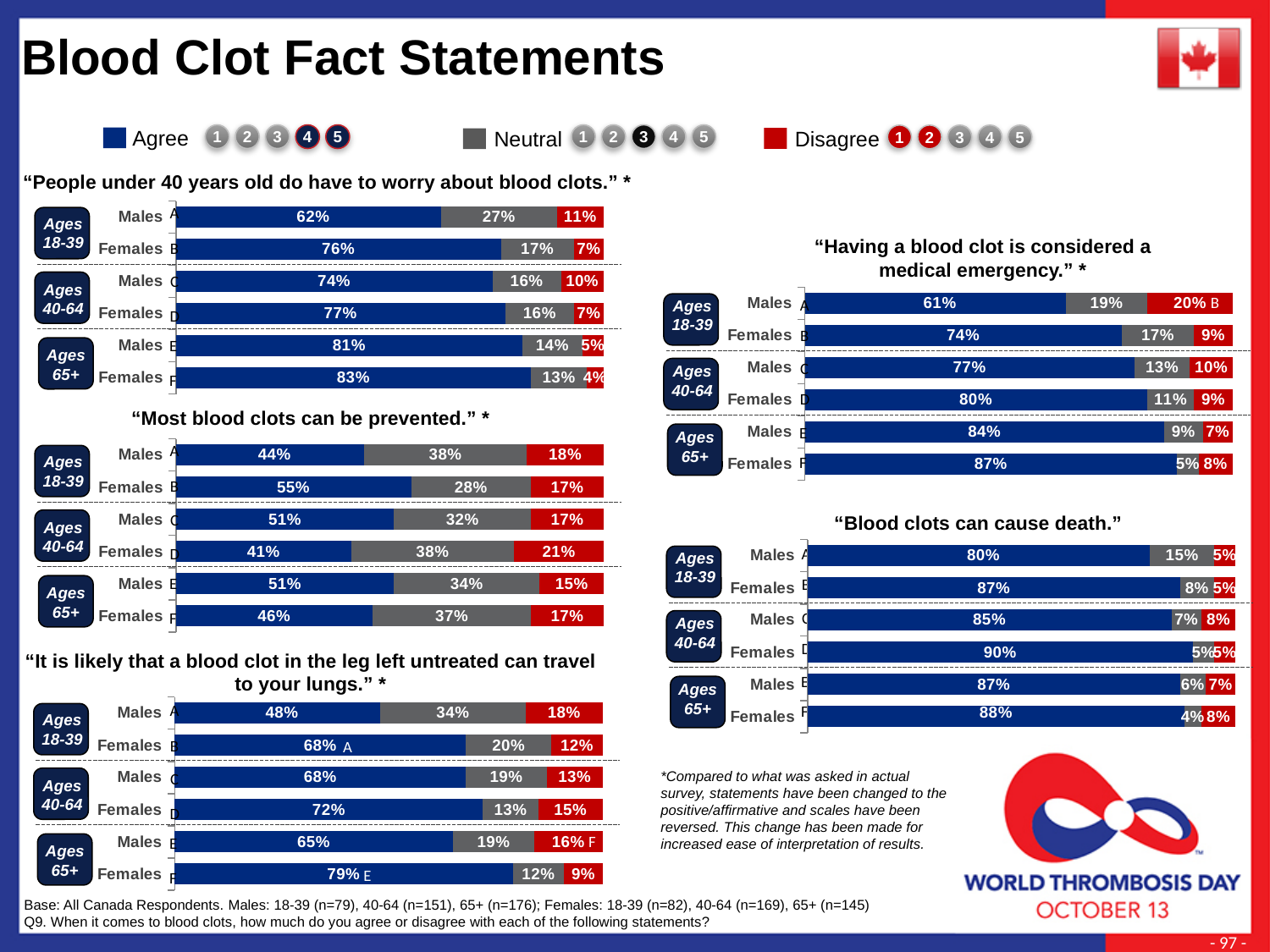
In the chart "Most blood clots can be prevented.", what is the Disagree percentage for Females aged 40-64? 21% In the chart "It is likely that a blood clot in the leg left untreated can travel to your lungs.", what is the Neutral percentage for Males aged 18-39? 34% In the chart "People under 40 years old do have to worry about blood clots.", which group has the highest Agree percentage? Females 65+ In the chart "It is likely that a blood clot in the leg left untreated can travel to your lungs.", what is the difference between the Agree percentages of Females 65+ and Males 65+? 14% In the chart "Blood clots can cause death.", what percentage of Females aged 40-64 agree? 90% In the chart "Most blood clots can be prevented.", which group has the lowest Agree percentage? Females 40-64 How many response categories does the legend at the top of the slide list? 3 What type of chart is used for "Most blood clots can be prevented."? Stacked bar chart In the chart "People under 40 years old do have to worry about blood clots.", what percentage of Males aged 18-39 agree? 62% In the chart "Having a blood clot is considered a medical emergency.", which group has the higher Agree percentage, Males 18-39 or Females 18-39? Females 18-39 In the chart "Having a blood clot is considered a medical emergency.", what is the Disagree percentage for Males aged 18-39? 20% In the chart "Blood clots can cause death.", how many respondent groups (bars) are shown? 6